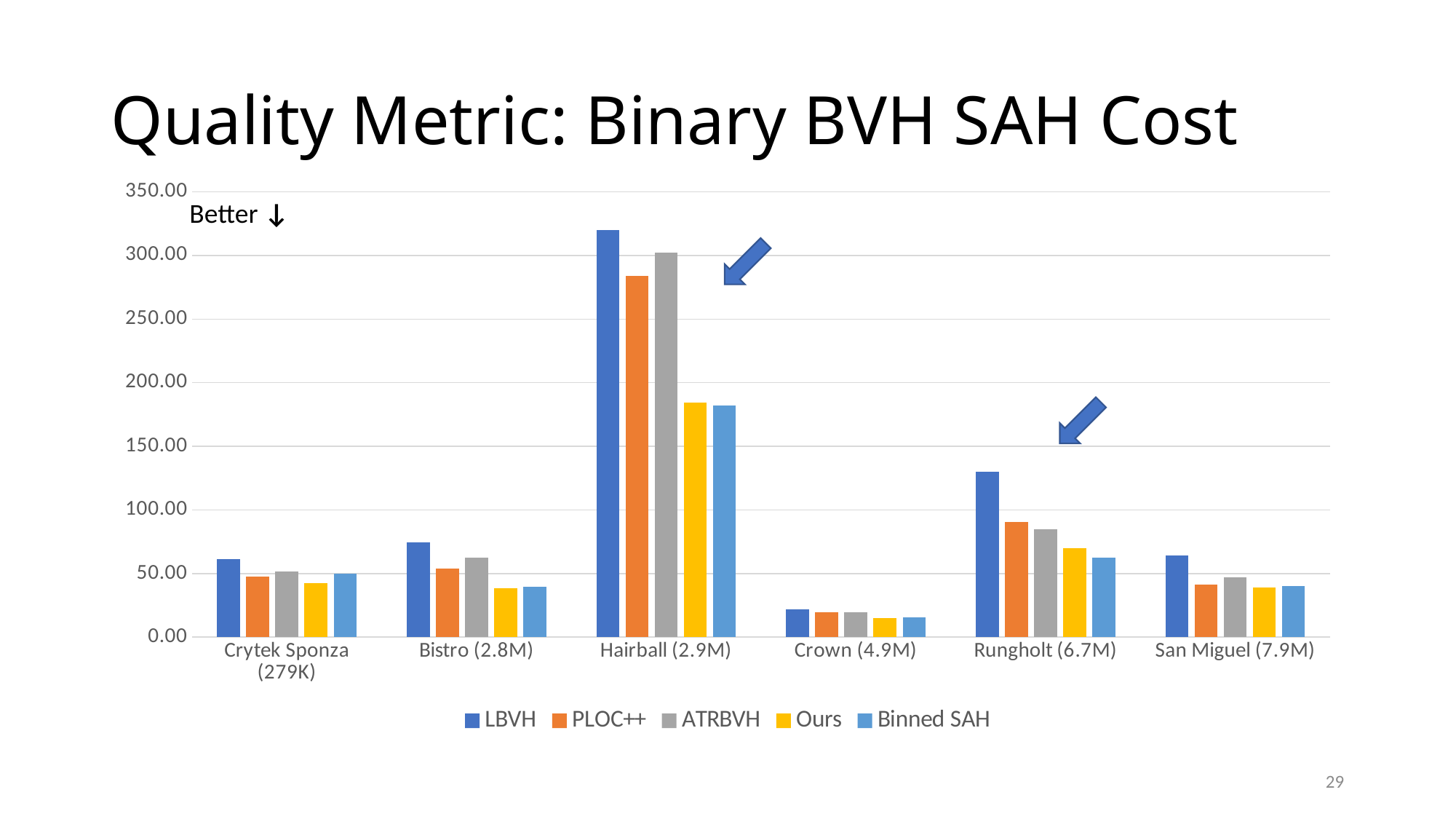
Is the LBVH value for Rungholt (6.7M) greater or less than 100.00? greater Which scene has the lowest LBVH value? Crown (4.9M) How many scene categories are shown along the x axis? 6 Is the Ours value for Hairball (2.9M) greater or less than 200.00? less For Rungholt (6.7M), which is larger: the LBVH value or the PLOC++ value? LBVH How many series does the legend list? 5 For Hairball (2.9M), which is larger: the ATRBVH value or the PLOC++ value? ATRBVH Which scene has the highest LBVH value? Hairball (2.9M) Is the LBVH value for Hairball (2.9M) greater or less than 300.00? greater What is the title of the chart on the slide? Quality Metric: Binary BVH SAH Cost What kind of chart is shown on the slide? bar chart Which series has the highest value for Hairball (2.9M)? LBVH